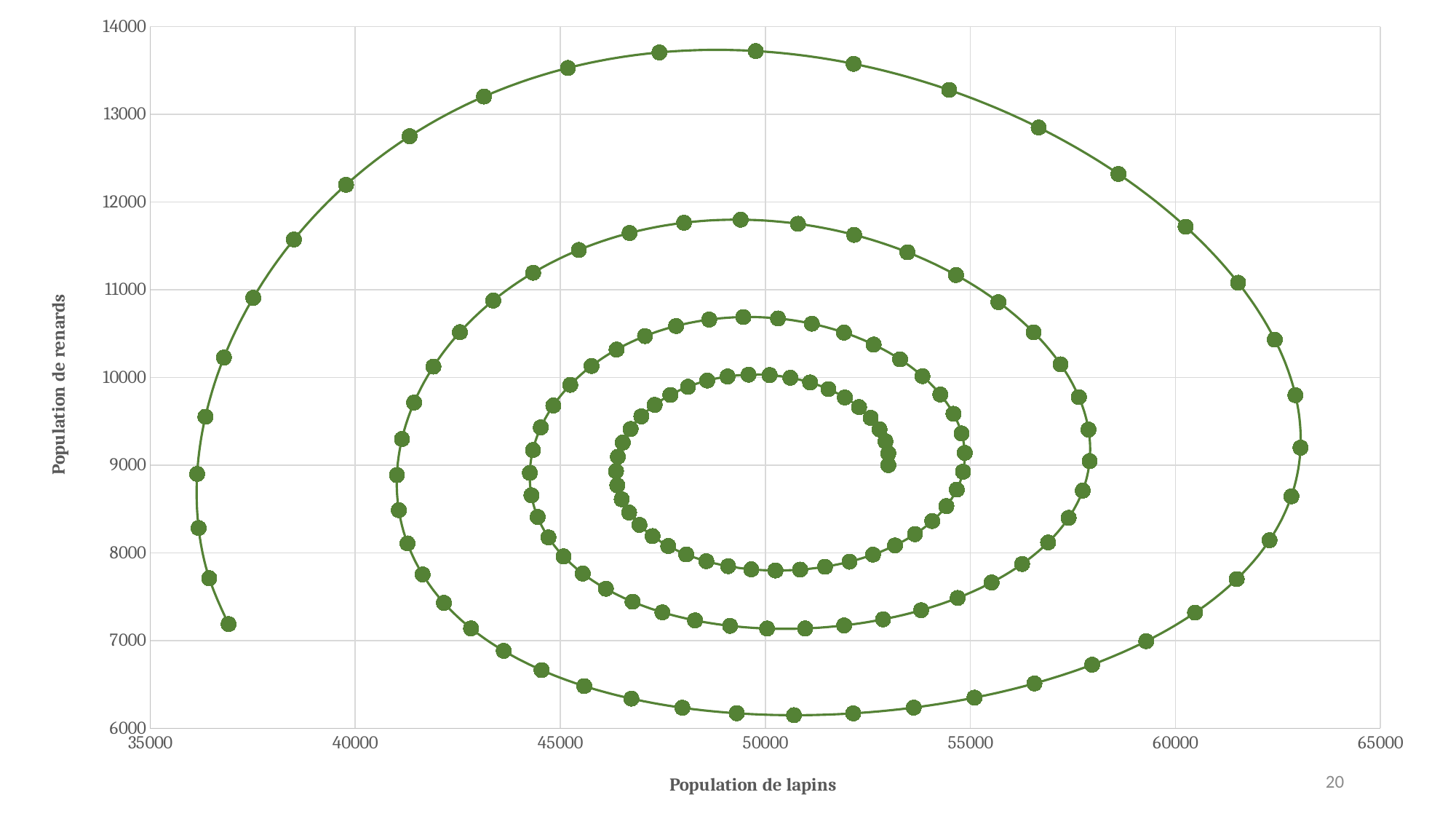
What is the title of the horizontal axis? Population de lapins Is the lowest rabbit population (Population de lapins) plotted greater or less than 40000? less Is the highest fox population (Population de renards) plotted greater or less than 13000? greater What kind of chart is shown on the slide? scatter chart Is the highest rabbit population (Population de lapins) plotted greater or less than 60000? greater What is the title of the vertical axis? Population de renards